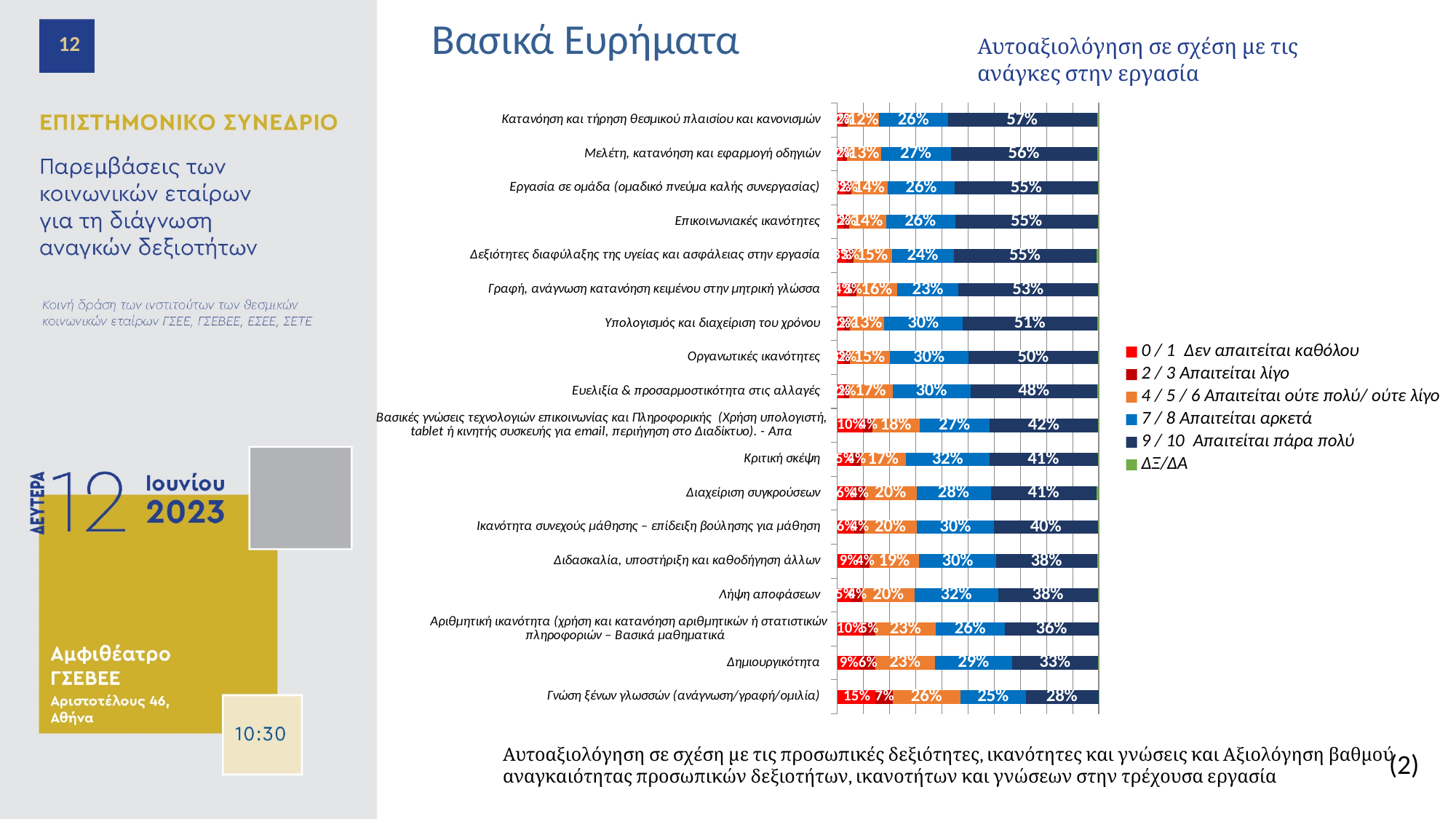
Which legend entry is shown in green? ΔΞ/ΔΑ Which category has the lowest value for the '9 / 10 Απαιτείται πάρα πολύ' series? Γνώση ξένων γλωσσών (ανάγνωση/γραφή/ομιλία) What is the value of the '9 / 10 Απαιτείται πάρα πολύ' series for 'Κατανόηση και τήρηση θεσμικού πλαισίου και κανονισμών'? 57% What is the value of the '7 / 8 Απαιτείται αρκετά' series for 'Υπολογισμός και διαχείριση του χρόνου'? 30% What type of chart is shown on the slide? stacked bar chart What is the value of the '4 / 5 / 6 Απαιτείται ούτε πολύ/ ούτε λίγο' series for 'Γνώση ξένων γλωσσών (ανάγνωση/γραφή/ομιλία)'? 26% Which category has the highest value for the '9 / 10 Απαιτείται πάρα πολύ' series? Κατανόηση και τήρηση θεσμικού πλαισίου και κανονισμών How many series does the legend list? 6 What is the value of the '0 / 1 Δεν απαιτείται καθόλου' series for 'Γνώση ξένων γλωσσών (ανάγνωση/γραφή/ομιλία)'? 15% What is the difference between the '9 / 10 Απαιτείται πάρα πολύ' values for 'Δημιουργικότητα' and 'Γνώση ξένων γλωσσών (ανάγνωση/γραφή/ομιλία)'? 5% Which is larger: the '7 / 8 Απαιτείται αρκετά' value for 'Κριτική σκέψη' or for 'Διαχείριση συγκρούσεων'? Κριτική σκέψη How many categories (skills) are plotted in the chart? 18